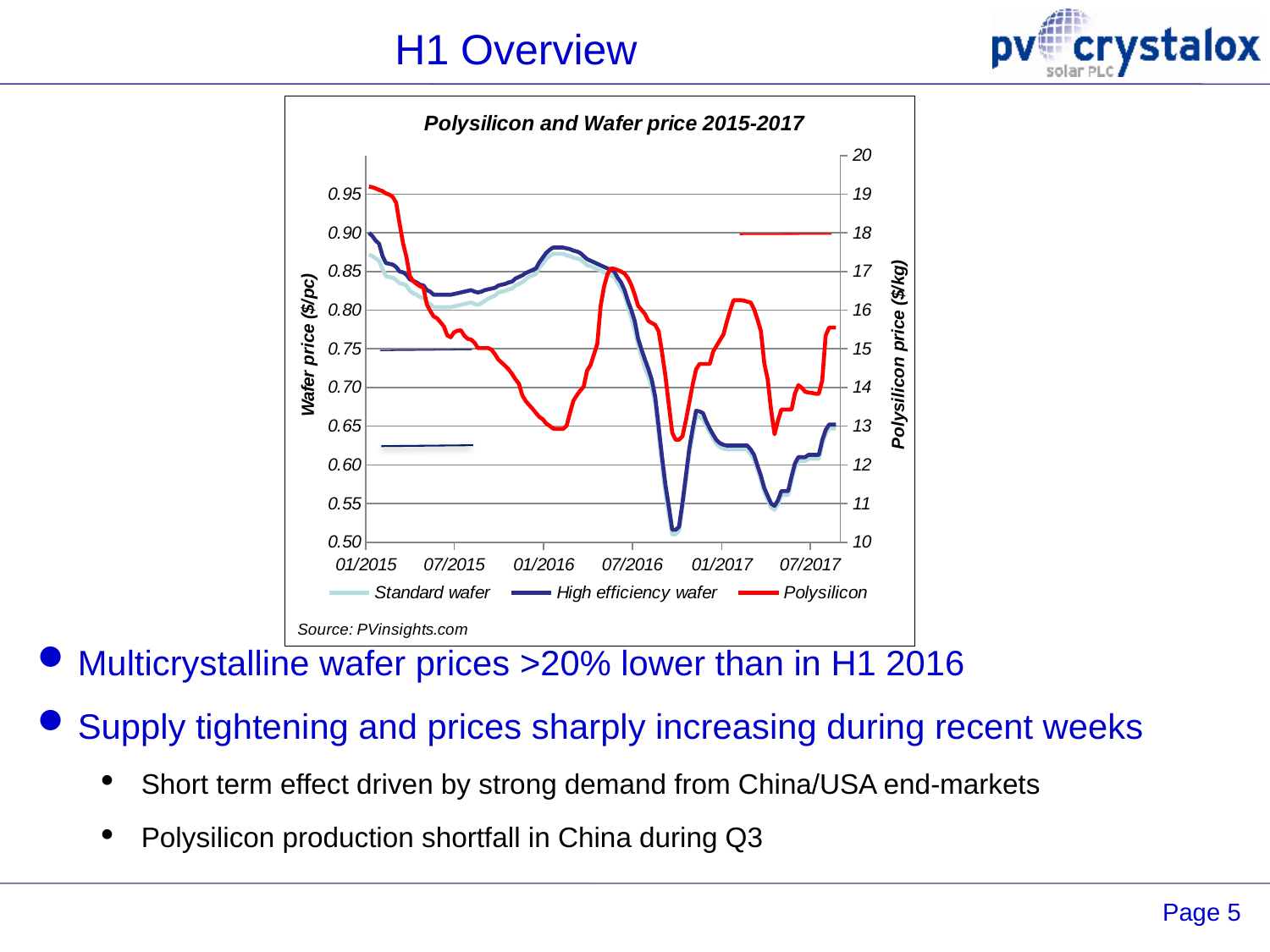
Does the Polysilicon price rise or fall between 01/2015 and 01/2016? Fall Is the lowest Polysilicon price reached around 01/2016 greater or less than 14 $/kg? less At 01/2015, which is higher: the Standard wafer price or the High efficiency wafer price? High efficiency wafer What is the title of the chart? Polysilicon and Wafer price 2015-2017 Is the Polysilicon price at 07/2015 greater or less than 15 $/kg? greater How many series does the chart legend list? 3 Does the High efficiency wafer price rise or fall between 07/2016 and 10/2016? Fall Is the Polysilicon price at 01/2015 greater or less than 18 $/kg? greater What kind of chart is shown on the slide? Line chart What is the label of the right-hand vertical axis? Polysilicon price ($/kg)